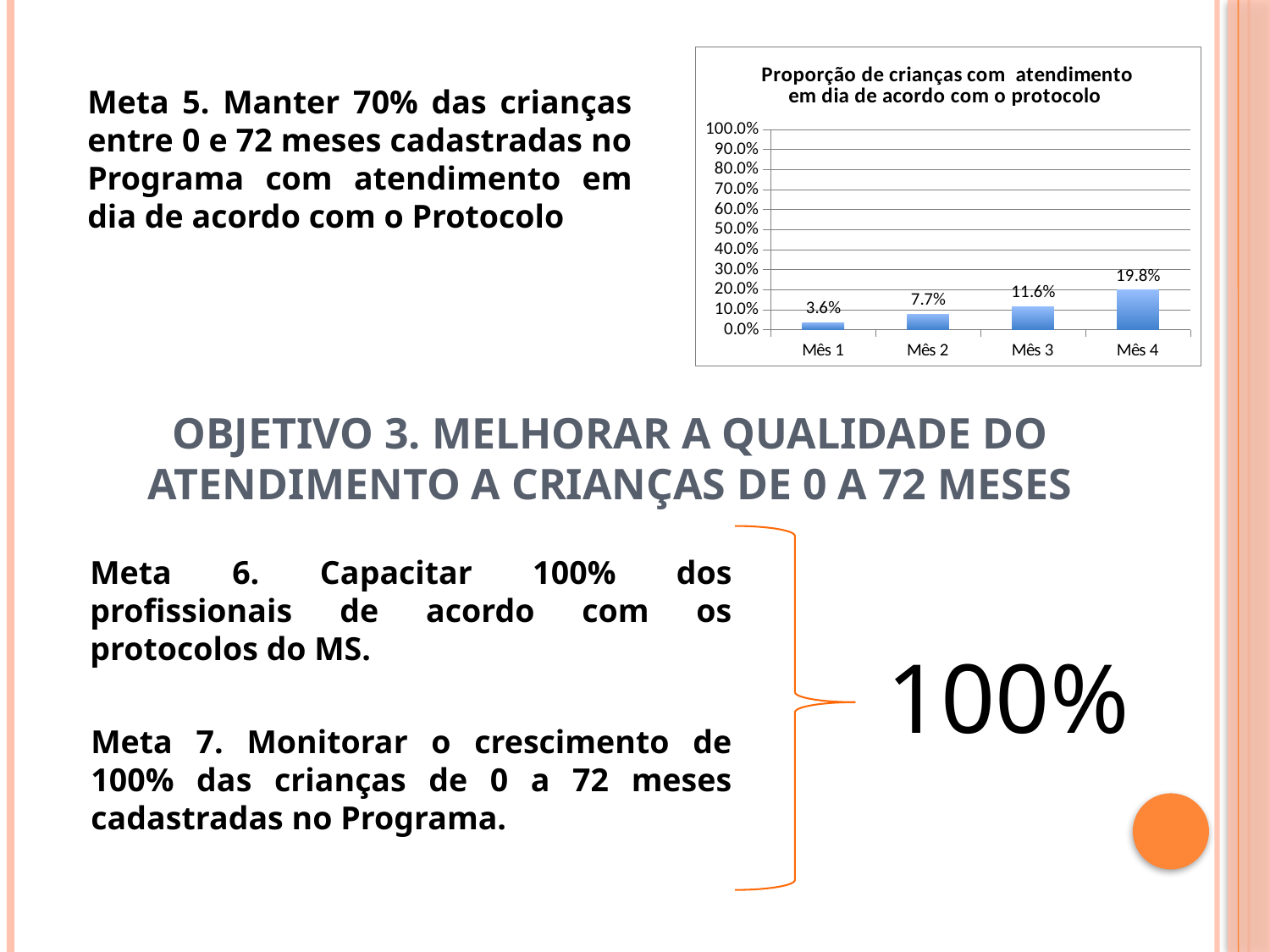
What is the value for Mês 4? 19.8% Which is larger, the value for Mês 2 or the value for Mês 3? Mês 3 Which month has the lowest value? Mês 1 What is the value for Mês 1? 3.6% Which month has the highest value? Mês 4 What is the difference between the values for Mês 4 and Mês 3? 8.2% What is the value for Mês 3? 11.6% What is the value for Mês 2? 7.7% What kind of chart is shown? bar chart Is the value for Mês 4 greater or less than 30.0%? less Do the values rise or fall from Mês 1 to Mês 4? rise How many months are shown on the x axis? 4